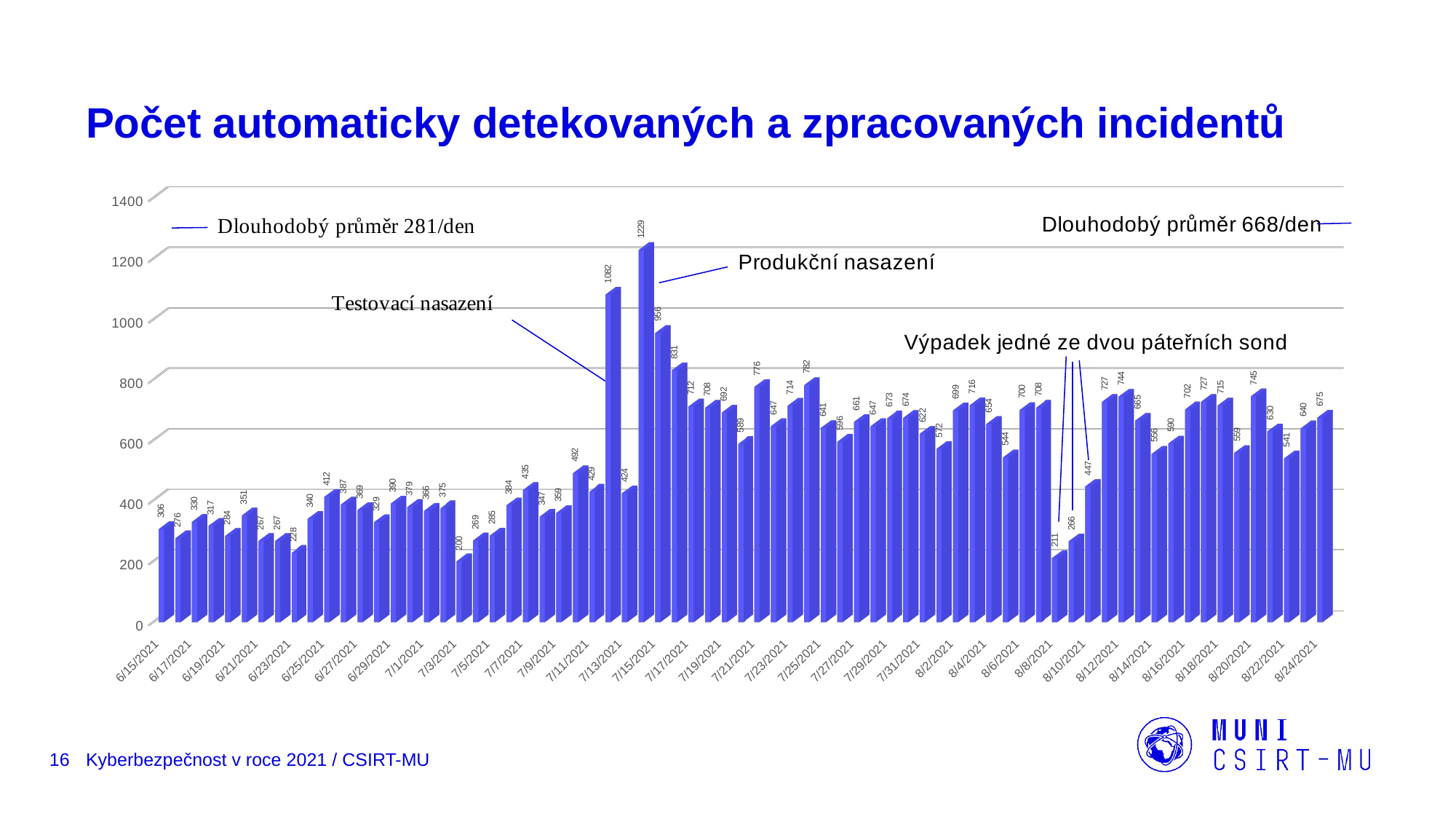
Are the daily values in August generally higher or lower than those in June? higher What is the value for the last bar, 8/24/2021? 675 Which has the larger value, 6/15/2021 or 8/24/2021? 8/24/2021 What is the difference between the highest value (1229) and the lowest value (200) in the chart? 1029 Is the value for 6/15/2021 greater or less than 400? less What long-term average is stated for the period before the production deployment (Produkční nasazení)? 281/den What kind of chart is shown on the slide? bar chart What is the value for the first bar, 6/15/2021? 306 What is the second-highest value shown in the chart? 1082 What is the highest daily value shown in the chart? 1229 What long-term average is stated for the period after the production deployment? 668/den What is the lowest daily value shown in the chart? 200